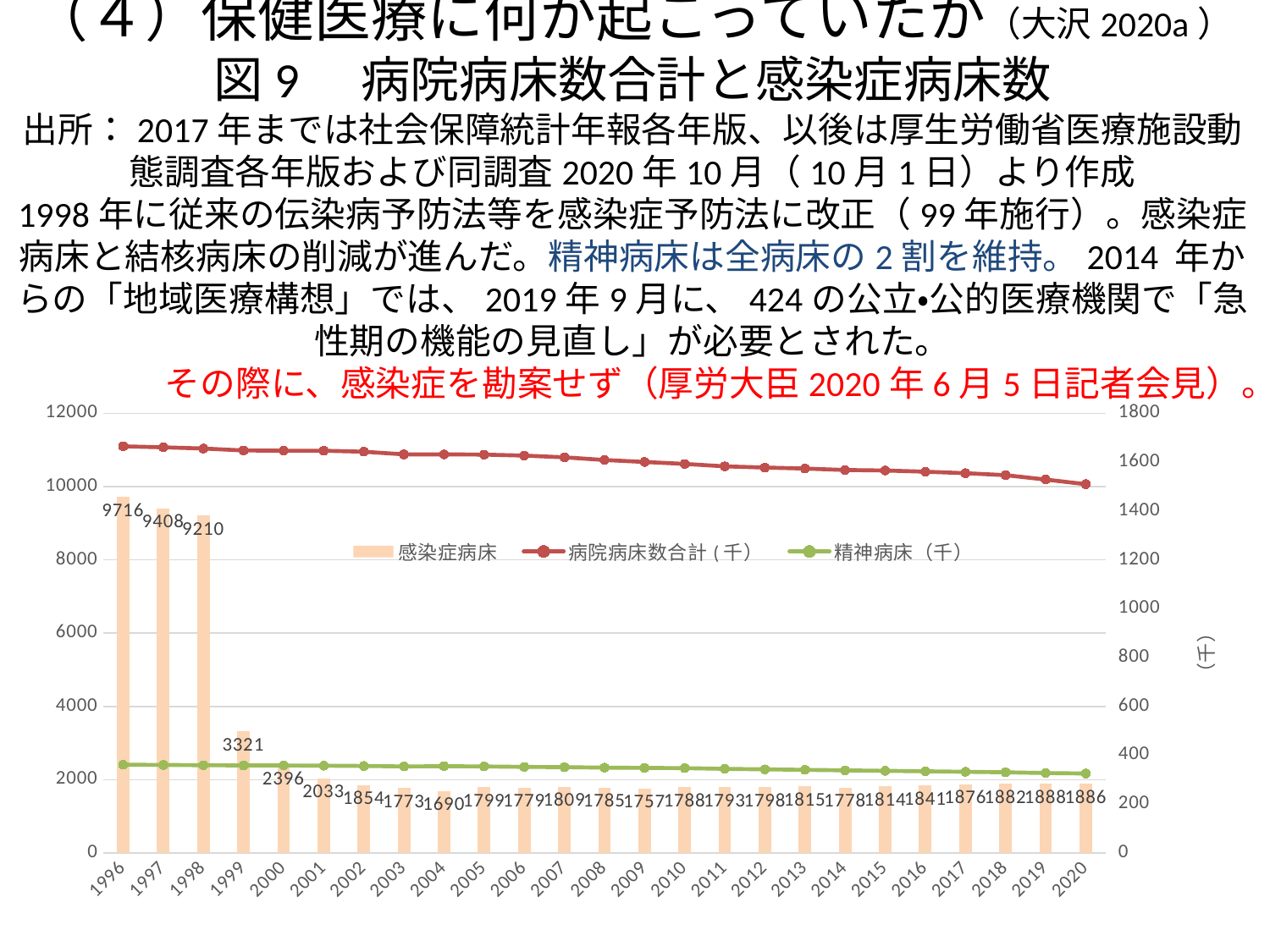
Which is larger, the 感染症病床 value for 1998 or for 1999? 1998 Does the 病院病床数合計 (千) line rise or fall from 1996 to 2020? fall What is the value of 感染症病床 in 2020? 1886 What is the difference between the 感染症病床 values for 1996 and 1997? 308 What is the value of 感染症病床 in 1999? 3321 How many years are shown on the x axis? 25 Which year has the lowest value of 感染症病床? 2004 Which year has the highest value of 感染症病床? 1996 What is the value of 感染症病床 in 1996? 9716 Is the 病院病床数合計 (千) value for 1996 greater or less than 1600 on the right axis? greater How many series does the legend list? 3 What is the value of 感染症病床 in 2004? 1690